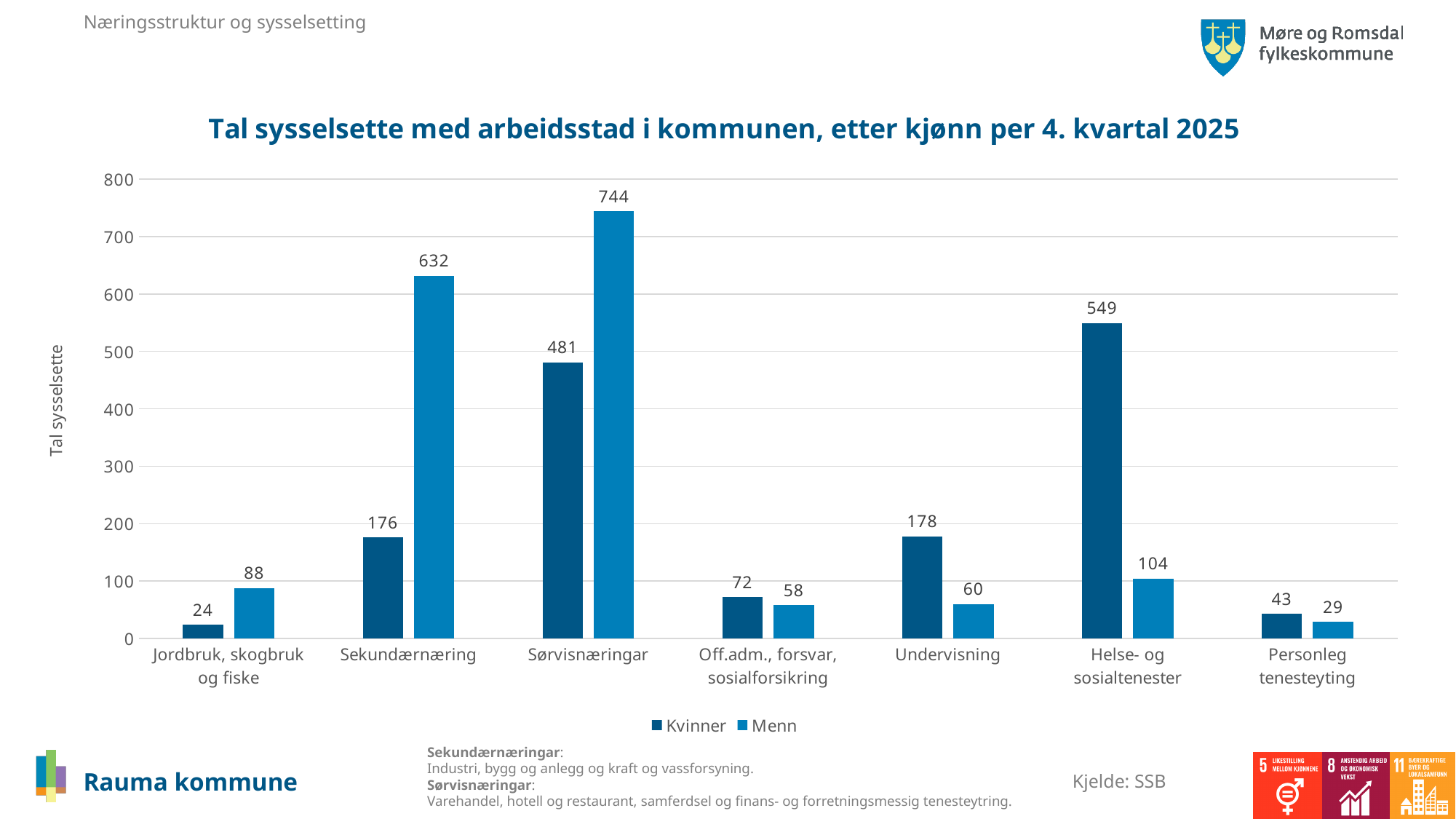
What is the value for Kvinner in Sørvisnæringar? 481 What kind of chart is shown? Bar chart What is the difference between Kvinner and Menn in Helse- og sosialtenester? 445 What is the value for Menn in Sekundærnæring? 632 How many categories are shown on the x axis? 7 Which category has the lowest value for Kvinner? Jordbruk, skogbruk og fiske How many series does the legend list? 2 What is the difference between Menn and Kvinner in Sørvisnæringar? 263 What is the value for Kvinner in Helse- og sosialtenester? 549 Which category has the highest value for Menn? Sørvisnæringar What is the label of the y axis? Tal sysselsette Which is larger in Undervisning, Kvinner or Menn? Kvinner